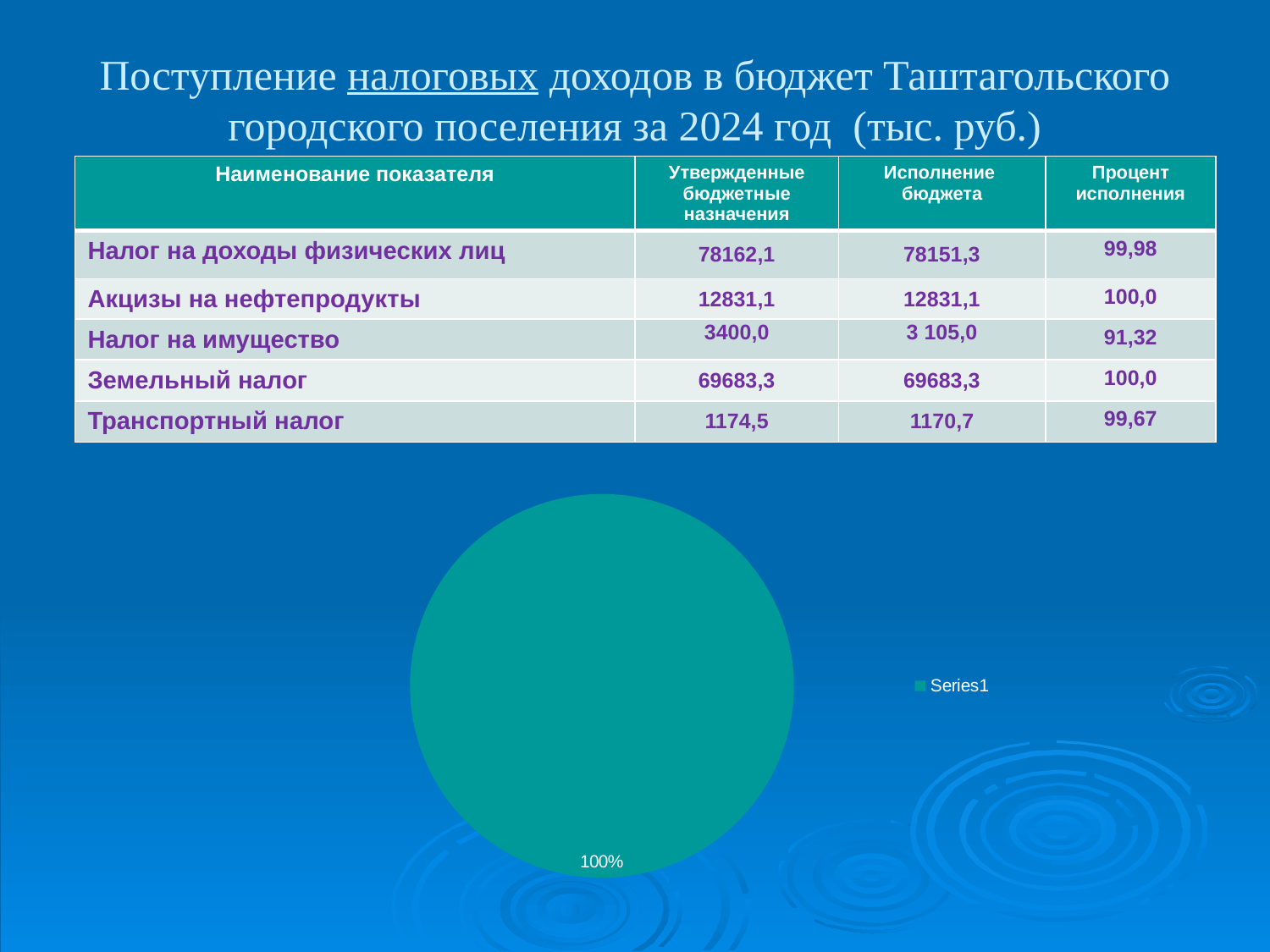
What share of the pie does the single slice represent, according to its data label? 100% How many series does the pie chart's legend list? 1 What is the name of the series listed in the pie chart's legend? Series1 What kind of chart is shown on the slide? pie chart What colour is the slice of the pie chart? teal green How many slices does the pie chart have? 1